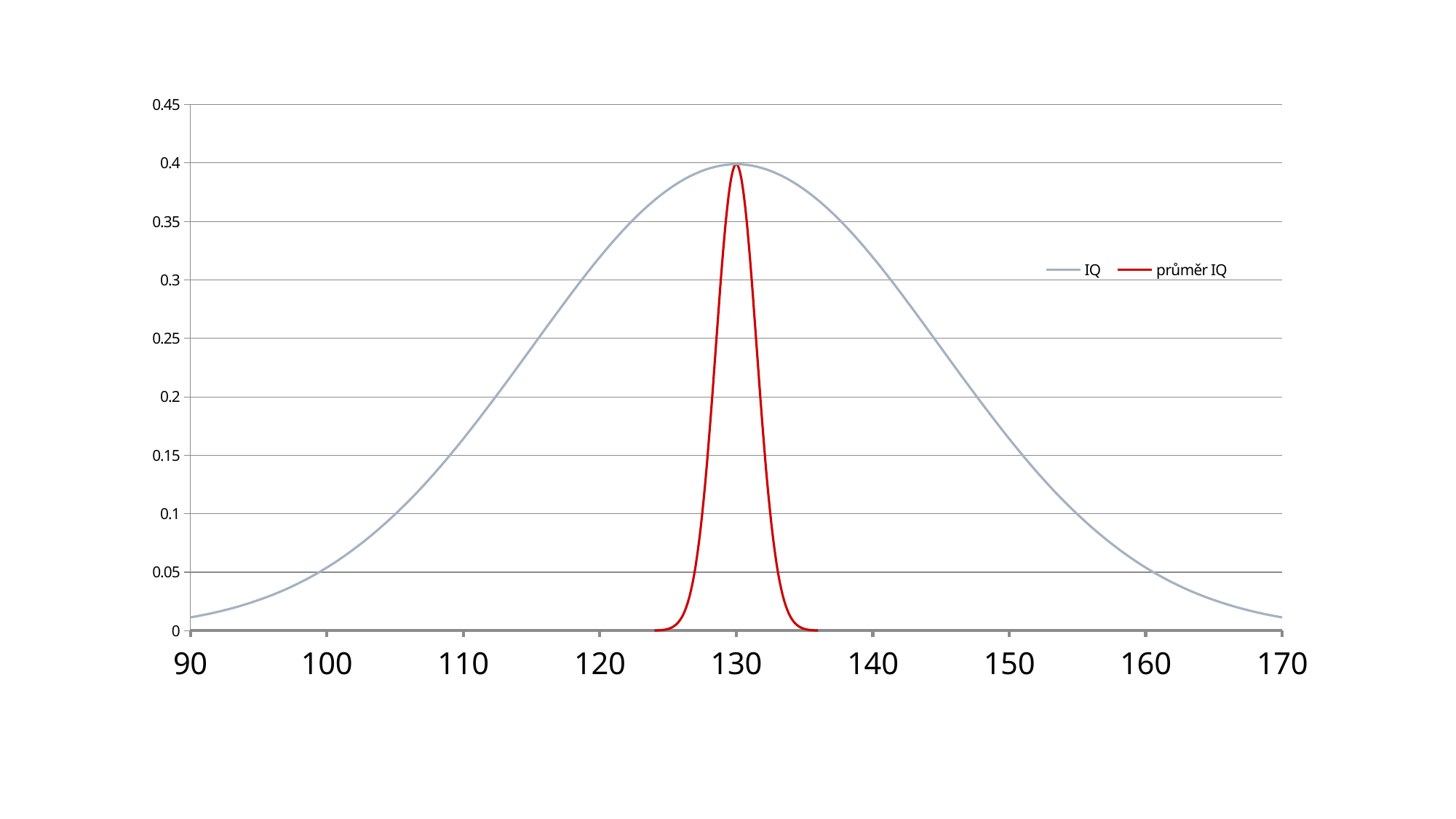
Does the IQ series rise or fall as the x axis goes from 90 to 130? rise How many series does the legend list? 2 Is the value of the IQ series at 130 greater or less than 0.35? greater Does the IQ series rise or fall as the x axis goes from 130 to 170? fall What colour is the line for the series průměr IQ? red At which x-axis value does the průměr IQ series reach its peak? 130 Is the value of the IQ series at 90 greater or less than 0.05? less Is the value of the IQ series at 170 greater or less than 0.05? less What are the two series named in the legend? IQ and průměr IQ What kind of chart is shown on the slide? line chart